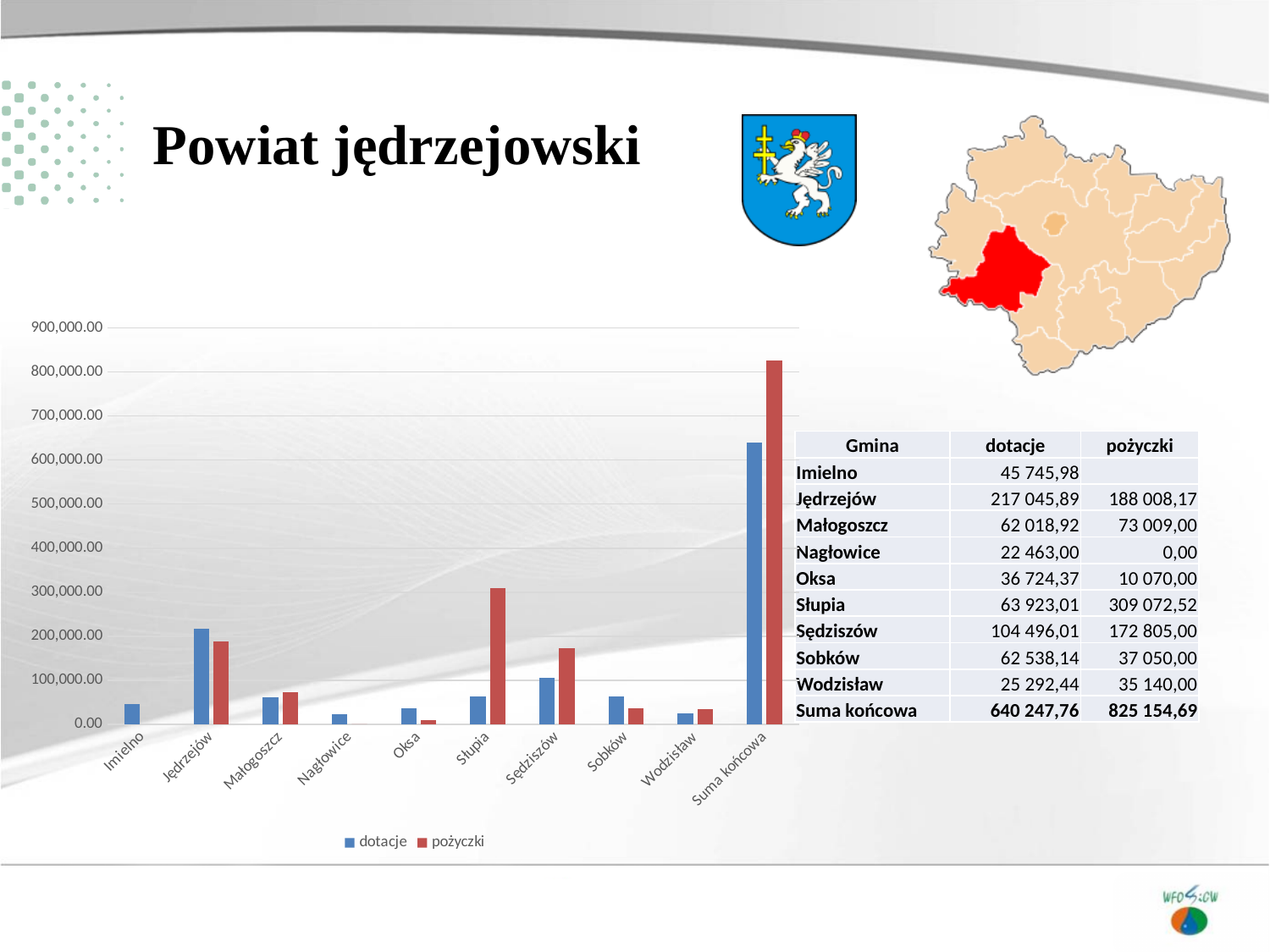
What is the dotacje value for Jędrzejów? 217 045,89 What is the pożyczki value for Słupia? 309 072,52 How many categories are shown along the x axis of the chart? 10 What is the difference between the dotacje and pożyczki values for Jędrzejów? 29 037,72 What is the dotacje value for Suma końcowa? 640 247,76 What kind of chart is shown on the slide? bar chart For Sędziszów, which is larger: dotacje or pożyczki? pożyczki How many series does the chart legend list? 2 Among the individual gminas (excluding Suma końcowa), which has the highest pożyczki value? Słupia Which gmina has the lowest pożyczki value? Nagłowice Is the pożyczki value for Suma końcowa greater or less than 800,000.00? greater Among the individual gminas (excluding Suma końcowa), which has the highest dotacje value? Jędrzejów